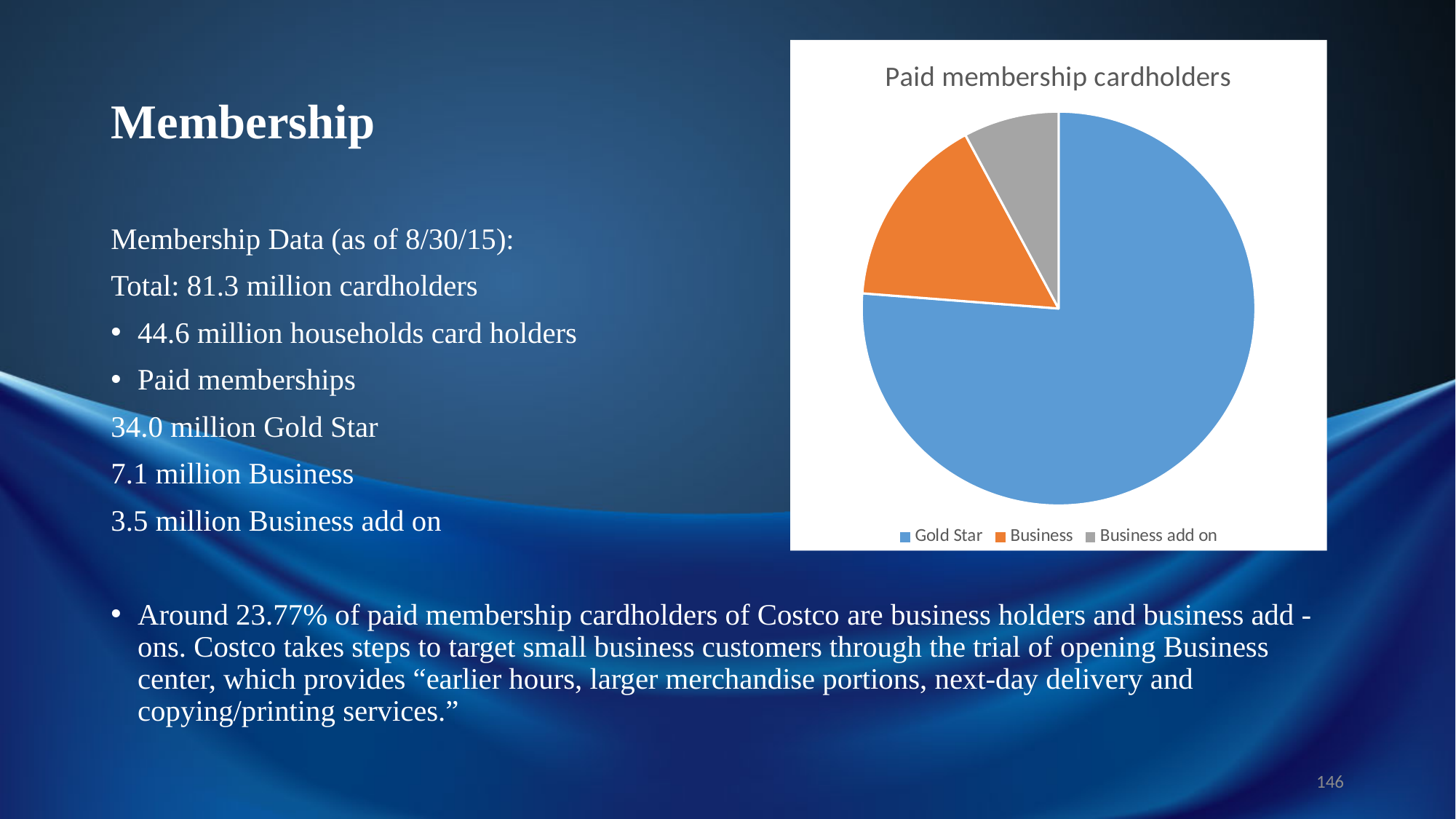
How many entries does the chart legend list? 3 What kind of chart is shown on the slide? Pie chart What colour is the Gold Star slice in the pie chart? Blue Which category has the smallest slice of the pie? Business add on Which category has the largest slice of the pie? Gold Star How many slices does the pie chart have? 3 What is the title of the chart? Paid membership cardholders What is the difference between the Business and Business add on cardholder counts? 3.6 million Which slice is larger, Business or Business add on? Business How many Gold Star paid membership cardholders are there according to the slide? 34.0 million How many Business add on paid membership cardholders are there according to the slide? 3.5 million How many Business paid membership cardholders are there according to the slide? 7.1 million